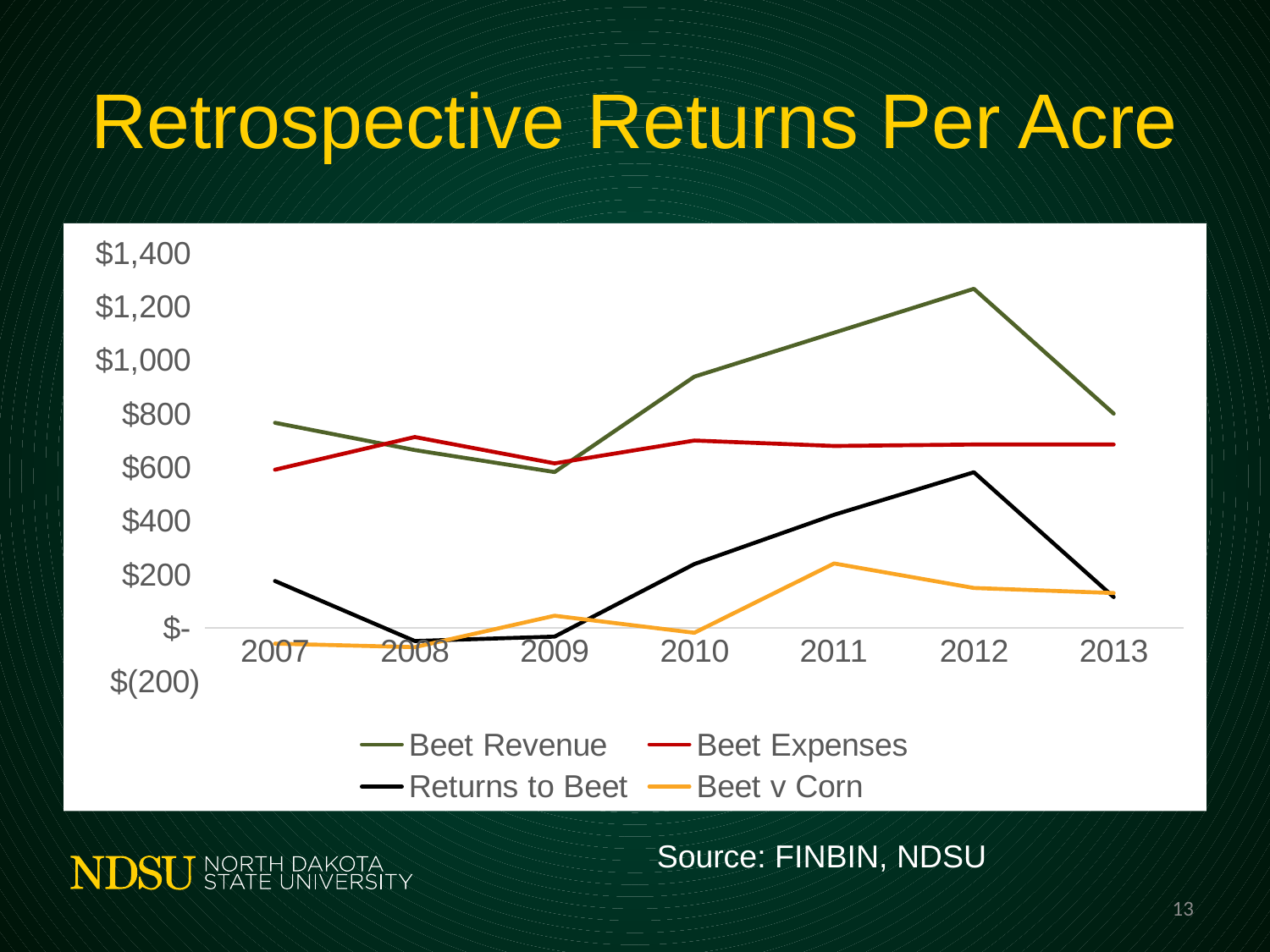
What is the title of the slide containing the chart? Retrospective Returns Per Acre How many years are plotted along the x axis? 7 Does Beet Revenue rise or fall from 2009 to 2012? Rise In which year is Beet Revenue lowest? 2009 Is the value for Beet Revenue in 2010 greater or less than $800? greater In 2008, which is larger: Beet Revenue or Beet Expenses? Beet Expenses What kind of chart is shown on the slide? Line chart In which year is Beet Revenue highest? 2012 Is the value for Beet Revenue in 2012 greater or less than $1,200? greater How many series does the legend list? 4 In which year is Returns to Beet highest? 2012 Is the value for Returns to Beet in 2012 greater or less than $400? greater